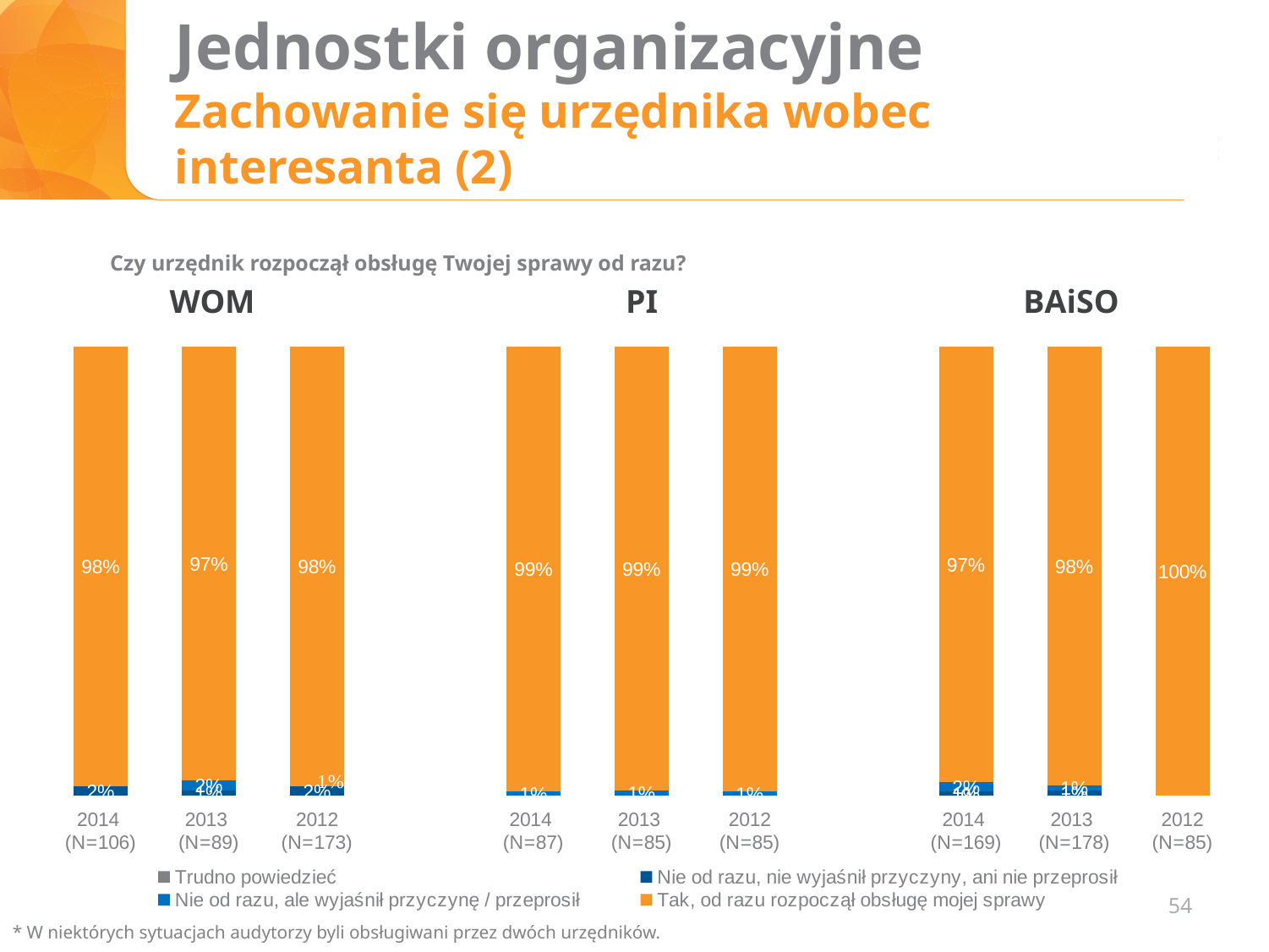
In the WOM chart, what is the value of the orange 'Tak, od razu rozpoczął obsługę mojej sprawy' segment for 2013 (N=89)? 97% How many series does the legend list? 4 How many bars does the PI chart contain? 3 In the PI chart, what is the value of the 'Tak, od razu rozpoczął obsługę mojej sprawy' segment for 2012 (N=85)? 99% In the WOM chart, which year has the lowest value for 'Tak, od razu rozpoczął obsługę mojej sprawy'? 2013 In the BAiSO chart, what is the value of the 'Tak, od razu rozpoczął obsługę mojej sprawy' segment for 2014 (N=169)? 97% In the BAiSO chart, what is the difference between the 'Tak, od razu rozpoczął obsługę mojej sprawy' values for 2012 and 2014? 3 percentage points What type of chart is used for WOM, PI and BAiSO? Stacked bar chart In the WOM chart, what is the value of the 'Tak, od razu rozpoczął obsługę mojej sprawy' segment for 2014 (N=106)? 98% In the BAiSO chart, which year has the highest value for 'Tak, od razu rozpoczął obsługę mojej sprawy'? 2012 Comparing the 2013 bars, is the 'Tak, od razu rozpoczął obsługę mojej sprawy' value larger in the WOM chart or the PI chart? PI In the BAiSO chart, what is the value of the 'Tak, od razu rozpoczął obsługę mojej sprawy' segment for 2012 (N=85)? 100%